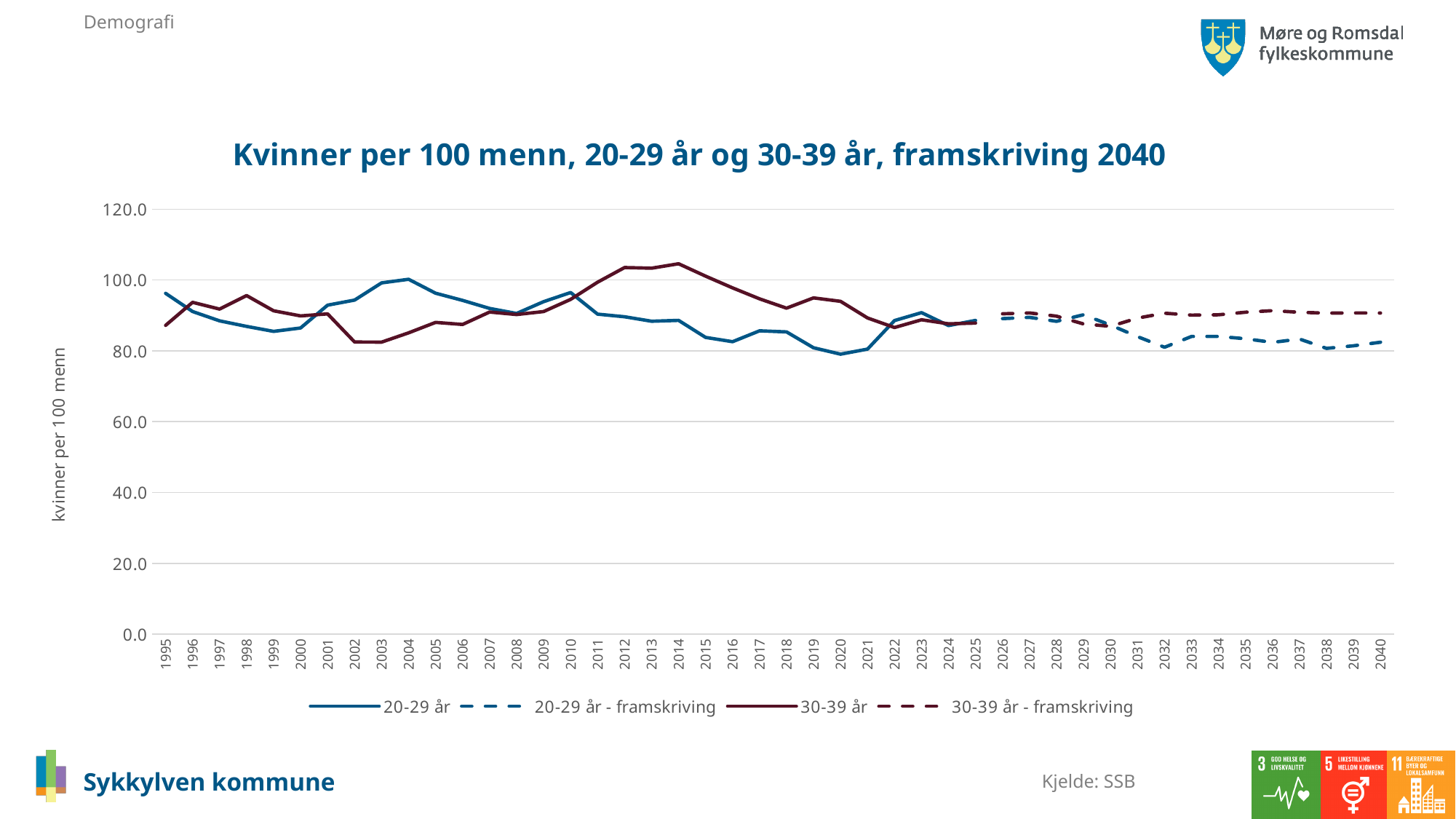
In 2040, which projection is higher, 20-29 år - framskriving or 30-39 år - framskriving? 30-39 år - framskriving In 2014, which series has the higher value, 20-29 år or 30-39 år? 30-39 år What kind of chart is shown on the slide? line chart Is the value for 30-39 år in 2002 greater or less than 100? less What is the label on the vertical axis? kvinner per 100 menn In which year does the 20-29 år series reach its lowest value? 2020 What is the title of the chart? Kvinner per 100 menn, 20-29 år og 30-39 år, framskriving 2040 Is the value for 20-29 år - framskriving in 2032 greater or less than 100? less Is the value for 30-39 år in 2014 greater or less than 100? greater How many series does the legend list? 4 In 2003, which series has the higher value, 20-29 år or 30-39 år? 20-29 år